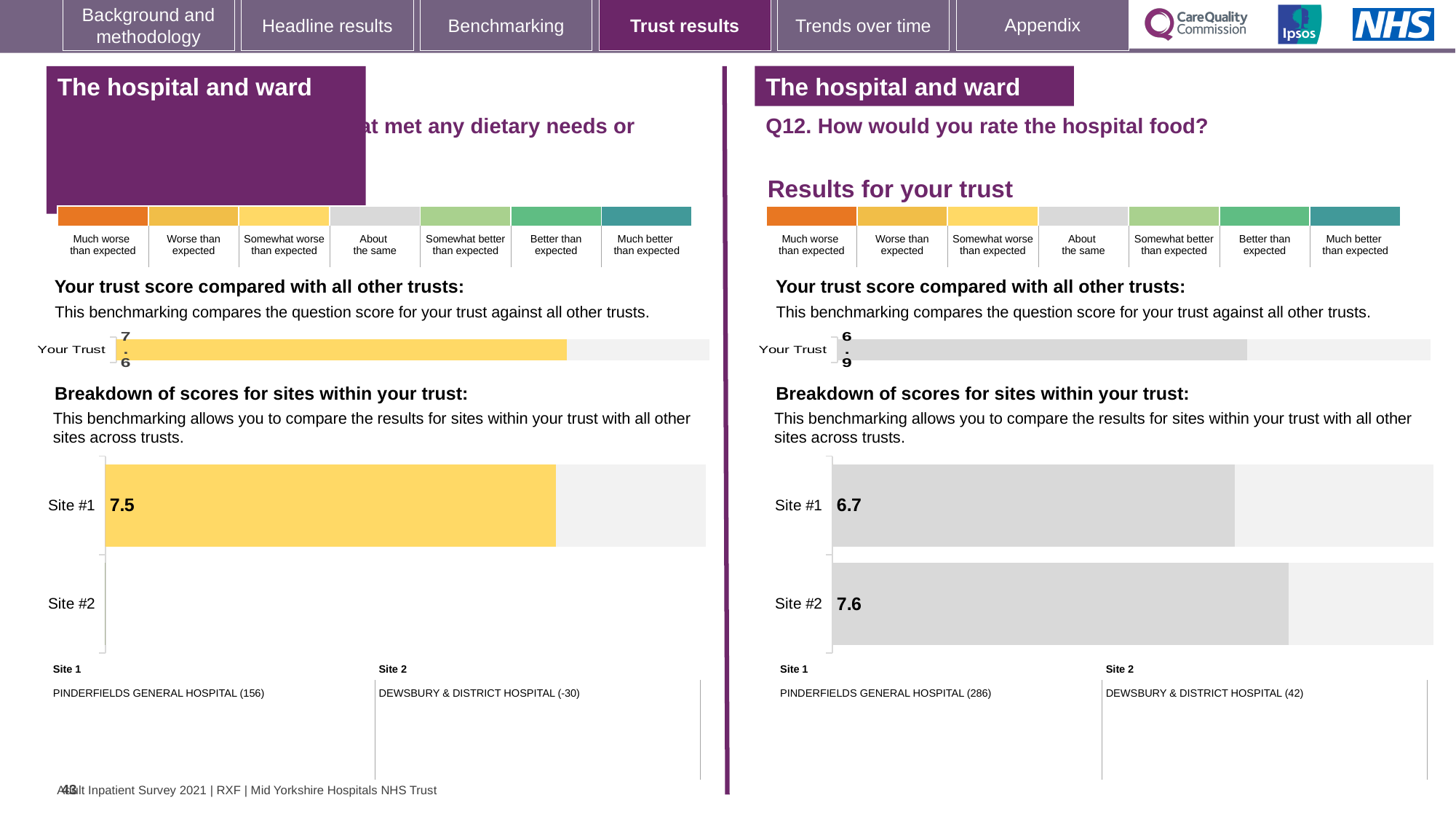
Is the Site #1 score on the left-hand breakdown chart larger or smaller than the Site #1 score on the right-hand Q12 breakdown chart? Larger On the right-hand chart for Q12 (Breakdown of scores for sites within your trust), what is the difference between the Site #2 and Site #1 scores? 0.9 What kind of chart is used for the Breakdown of scores for sites within your trust on the right-hand side? Bar chart On the left-hand chart (Your trust score compared with all other trusts), what is the score for Your Trust? 7.6 On the right-hand chart for Q12 (Your trust score compared with all other trusts), what is the score for Your Trust? 6.9 On the left-hand chart (Breakdown of scores for sites within your trust), what is the score for Site #1? 7.5 On the right-hand chart for Q12 (Breakdown of scores for sites within your trust), which site has the higher score? Site #2 On the left-hand chart (Breakdown of scores for sites within your trust), how many sites are listed on the axis? 2 On the right-hand chart for Q12 (Breakdown of scores for sites within your trust), what colour are the site bars? Grey On the right-hand chart for Q12 (Breakdown of scores for sites within your trust), what is the score for Site #1? 6.7 On the right-hand chart for Q12 (Breakdown of scores for sites within your trust), what is the score for Site #2? 7.6 On the left-hand chart (Breakdown of scores for sites within your trust), what colour is the Site #1 bar? Yellow